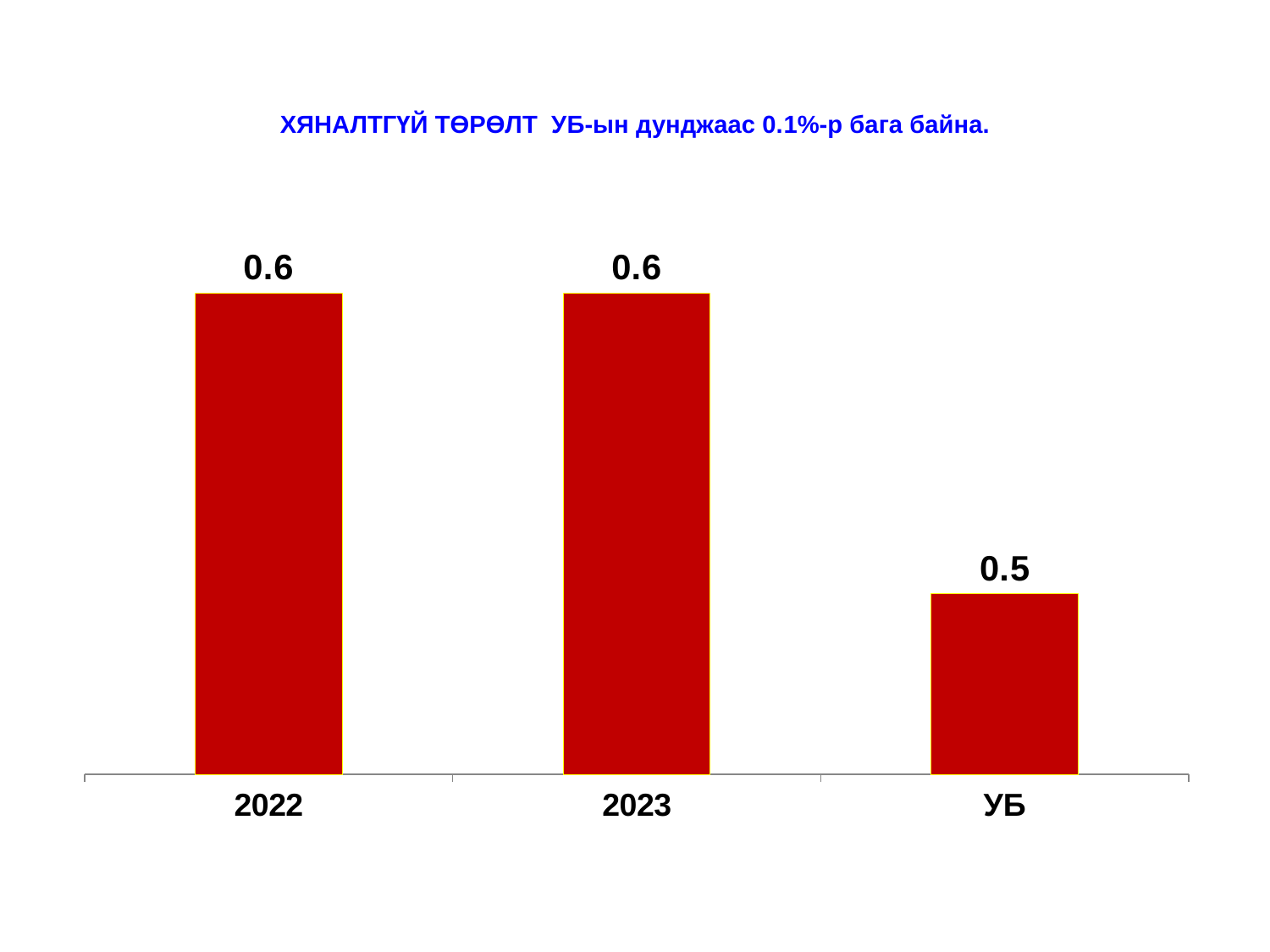
What is the difference between the value for 2023 and the value for УБ? 0.1 What kind of chart is shown on the slide? Bar chart What colour are the bars in the chart? Red What is the value for 2022? 0.6 What is the title of the slide? ХЯНАЛТГҮЙ ТӨРӨЛТ УБ-ын дунджаас 0.1%-р бага байна. How many bars are shown in the chart? 3 What is the value for УБ? 0.5 Do the values rise or fall from 2023 to УБ? Fall Which is larger, the value for 2022 or the value for УБ? 2022 Which category has the lowest value? УБ What is the value for 2023? 0.6